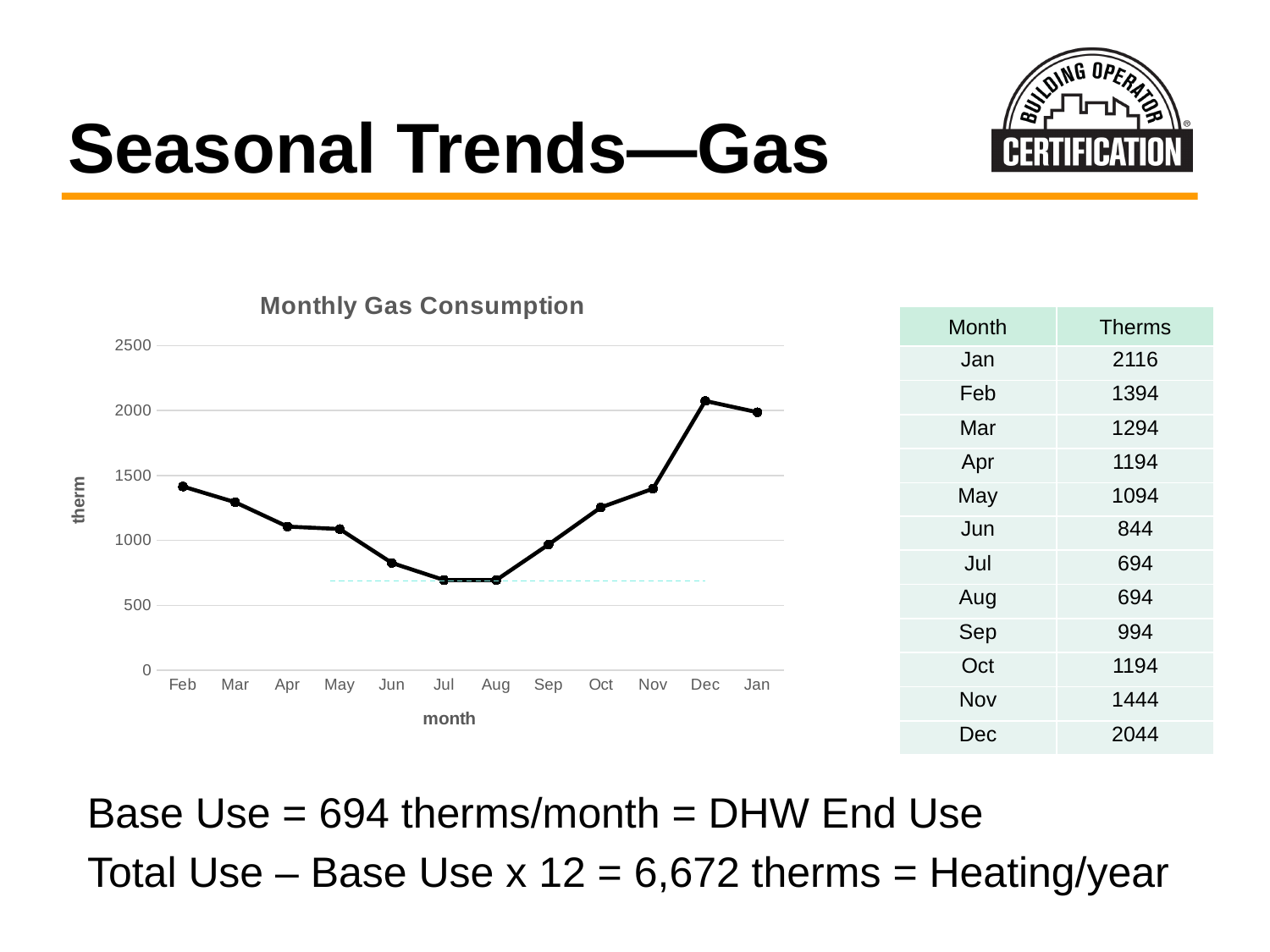
Using the table values, what is the difference in therms between Jan and Feb? 722 Which two months share the lowest gas consumption? Jul and Aug According to the table, how many therms were used in Sep? 994 How many months are plotted on the chart? 12 Which month has higher gas consumption, Mar or Sep? Mar Is the value for Jun greater or less than 1000? less Is the value for Nov greater or less than 1000? greater What kind of chart is shown on the slide? line chart Do the values rise or fall from Feb to Jul along the x axis? fall According to the table, how many therms were used in Jan? 2116 What is the title of the chart? Monthly Gas Consumption What is the label on the vertical axis of the chart? therm